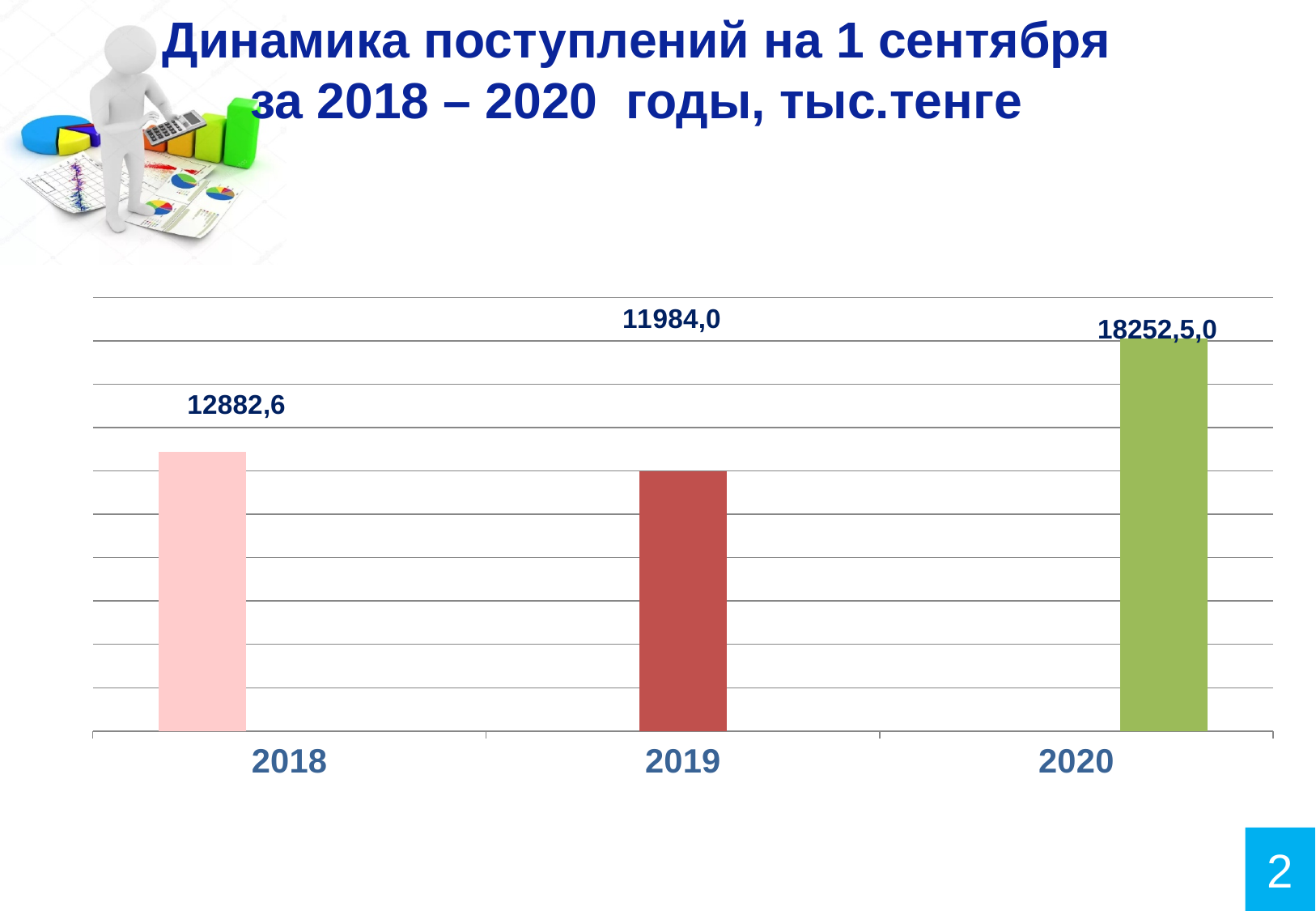
Which year has the lowest bar? 2019 Does the value rise or fall from 2019 to 2020? Rise What is the data label shown above the 2020 bar? 18252,5,0 Which is larger, the value for 2018 or the value for 2019? 2018 What is the difference between the values for 2018 and 2019? 898,6 What colour is the bar for 2020? Green What is the value for 2018? 12882,6 What is the value for 2019? 11984,0 What is the title of the slide? Динамика поступлений на 1 сентября за 2018 – 2020 годы, тыс.тенге How many years are shown on the x axis? 3 Which year has the highest bar? 2020 What kind of chart is shown on the slide? Bar chart